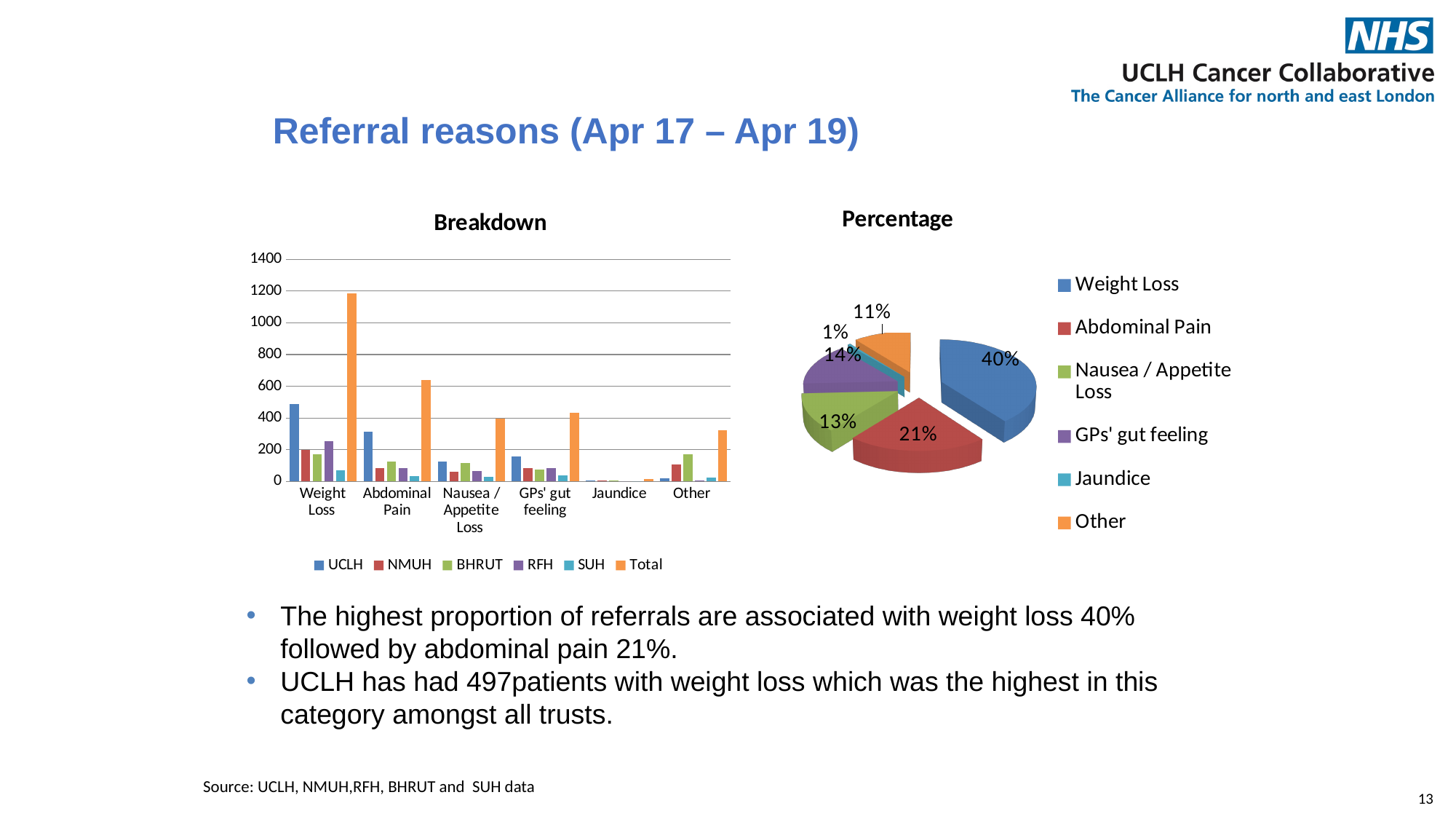
What kind of chart is the Breakdown chart? bar chart In the Percentage pie chart, which is larger: the share for Nausea / Appetite Loss or the share for Other? Nausea / Appetite Loss In the Percentage pie chart, what share of referrals is for Weight Loss? 40% How many series does the legend of the Breakdown chart list? 6 In the Breakdown chart, which category has the highest Total bar? Weight Loss How many referral reason categories are shown on the x axis of the Breakdown chart? 6 In the Percentage pie chart, which referral reason has the smallest slice? Jaundice In the Percentage pie chart, what share of referrals is for Abdominal Pain? 21% In the Percentage pie chart, what is the difference between the Weight Loss share and the Abdominal Pain share? 19% In the Breakdown chart, is the Total value for Weight Loss greater or less than 1000? greater In the Percentage pie chart, what share of referrals is for Jaundice? 1% In the Percentage pie chart, what share of referrals is for GPs' gut feeling? 14%